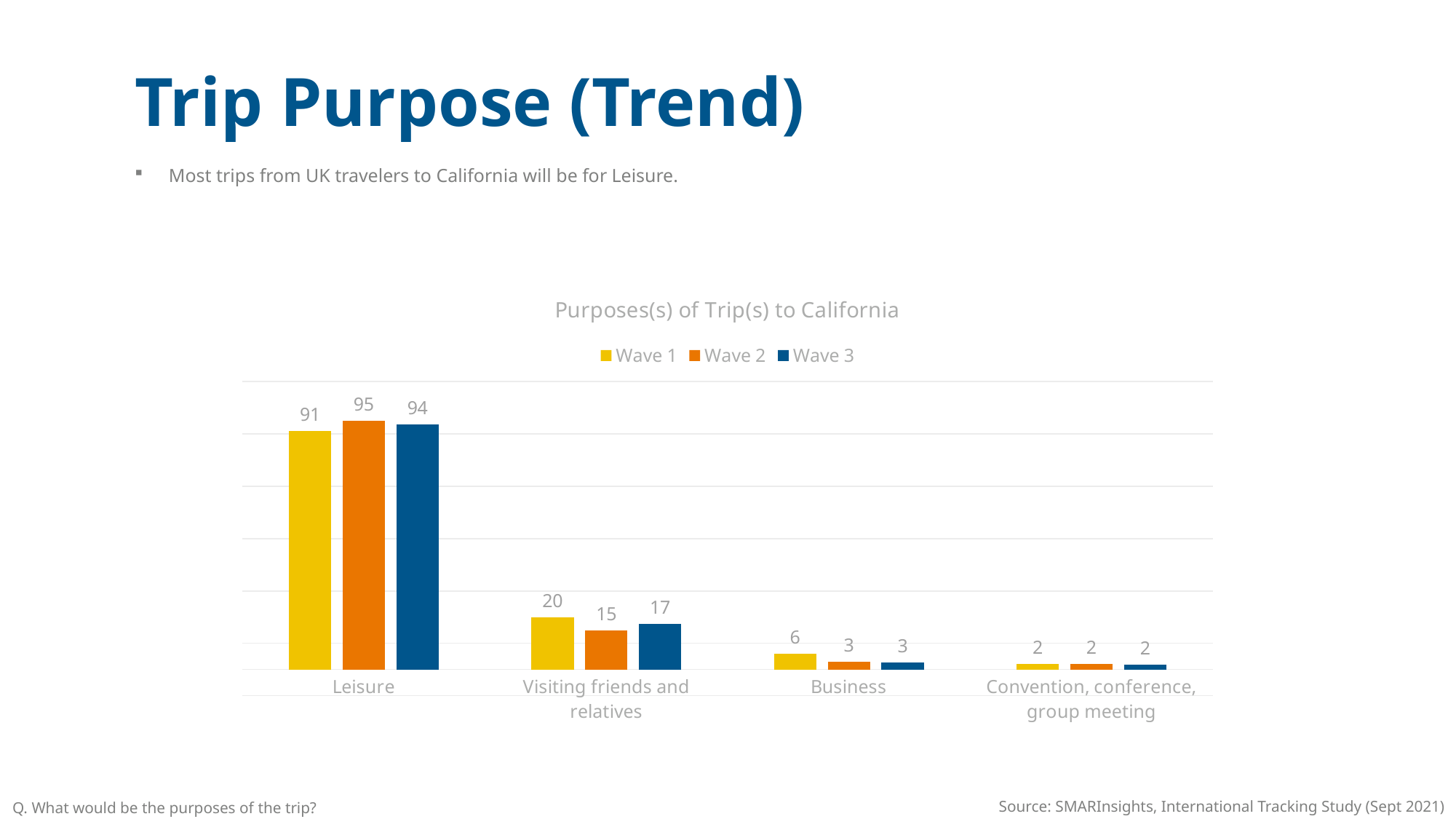
How many series does the legend list? 3 What kind of chart is shown on the slide? Bar chart What is the Wave 1 value for Visiting friends and relatives? 20 Which category has the highest Wave 3 value? Leisure Which is larger for Business: the Wave 1 value or the Wave 2 value? Wave 1 What is the title of the chart? Purposes(s) of Trip(s) to California How many categories are shown on the x axis? 4 What is the Wave 3 value for Business? 3 Do the Wave 2 values rise or fall from Leisure to Convention, conference, group meeting? Fall What is the difference between the Wave 1 and Wave 3 values for Visiting friends and relatives? 3 Which category has the lowest Wave 1 value? Convention, conference, group meeting What is the Wave 2 value for Leisure? 95